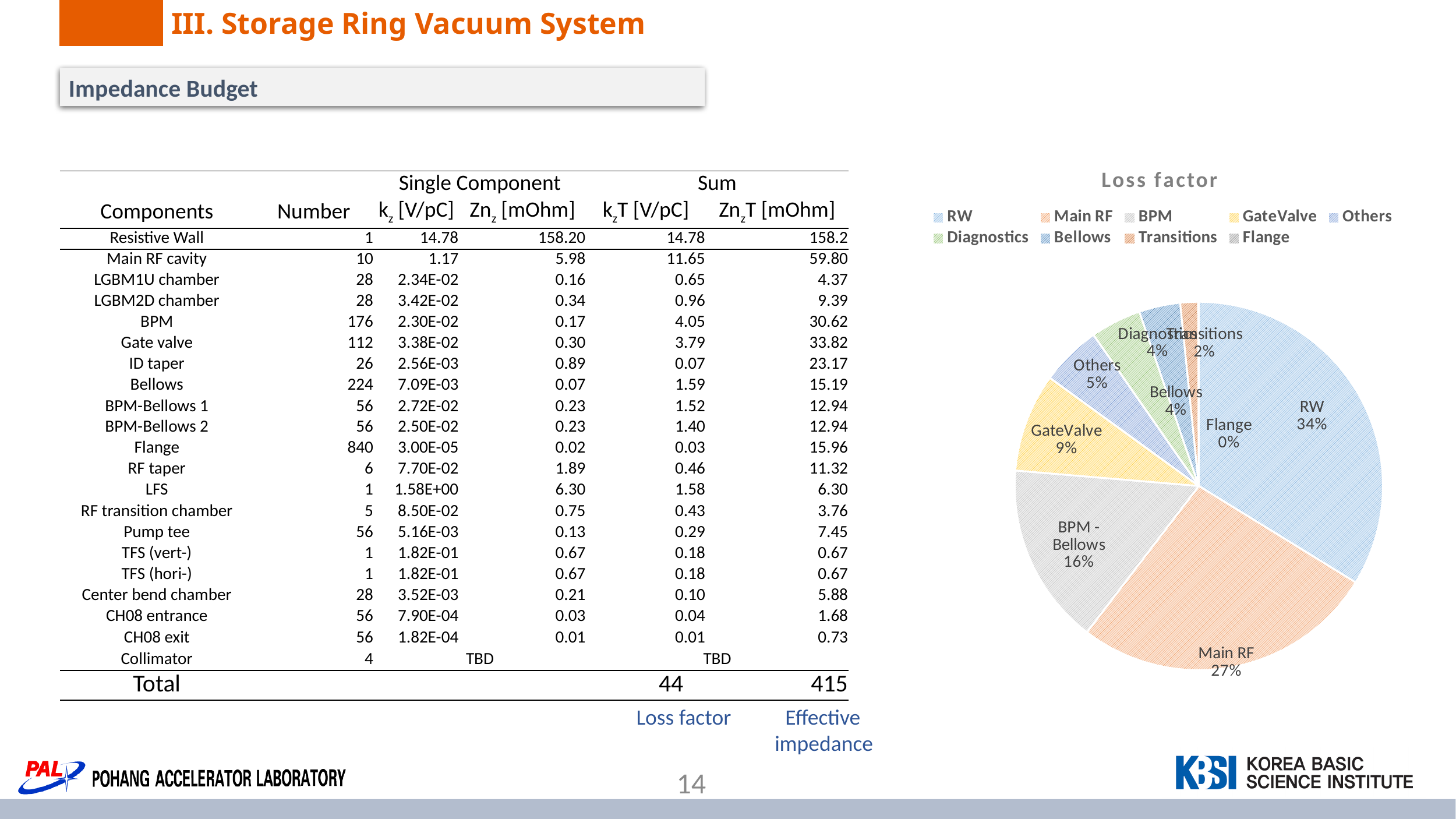
In the "Loss factor" pie chart, what share is shown for the slice labelled "BPM - Bellows"? 16% What is the title of the pie chart on the slide? Loss factor In the "Loss factor" pie chart, which category has the largest share? RW In the "Loss factor" pie chart, what share is shown for Main RF? 27% In the "Loss factor" pie chart, what is the difference in percentage points between the RW share and the Main RF share? 7 In the "Loss factor" pie chart, which category has the smallest share? Flange In the "Loss factor" pie chart, what share is shown for Transitions? 2% How many entries does the legend of the "Loss factor" pie chart list? 9 In the "Loss factor" pie chart, what share is shown for GateValve? 9% What kind of chart is the "Loss factor" chart? pie chart In the "Loss factor" pie chart, what share is shown for Others? 5% In the "Loss factor" pie chart, which is larger, the share for GateValve or the share for Others? GateValve